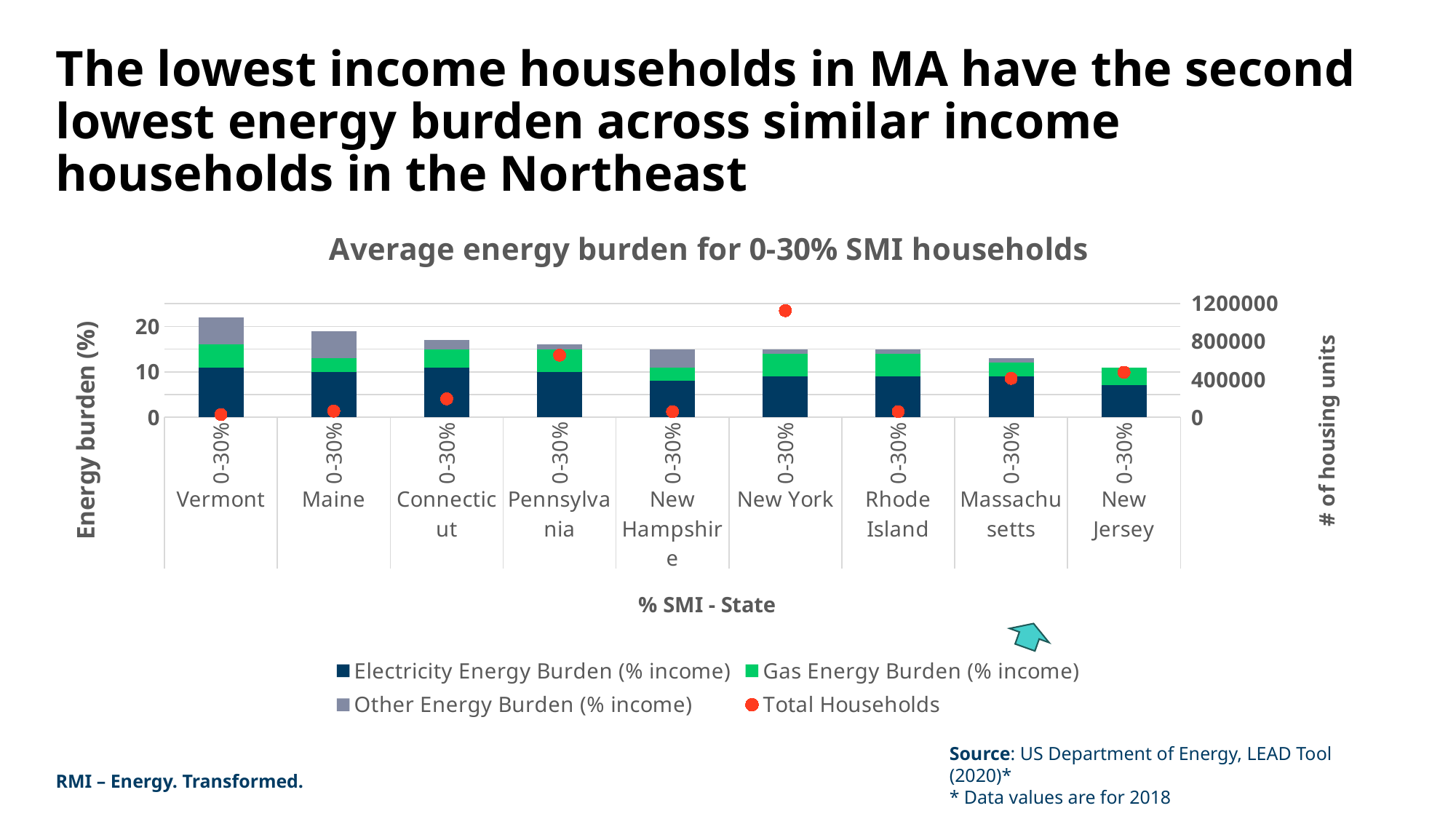
Do the total energy burden bars generally rise or fall from left to right across the states? fall Is the Total Households value for New York greater or less than 800000? greater Is the total energy burden for New Jersey greater or less than 20? less What is the title of the chart? Average energy burden for 0-30% SMI households Which state has the larger total energy burden, Vermont or New Jersey? Vermont How many states are shown on the x axis of the chart? 9 What kind of chart is shown on the slide? Stacked bar chart with a dot series for Total Households How many series does the chart's legend list? 4 Is the Total Households value for Vermont greater or less than 400000? less Which state has the lowest total energy burden (shortest stacked bar)? New Jersey Which state has the highest total energy burden (tallest stacked bar)? Vermont